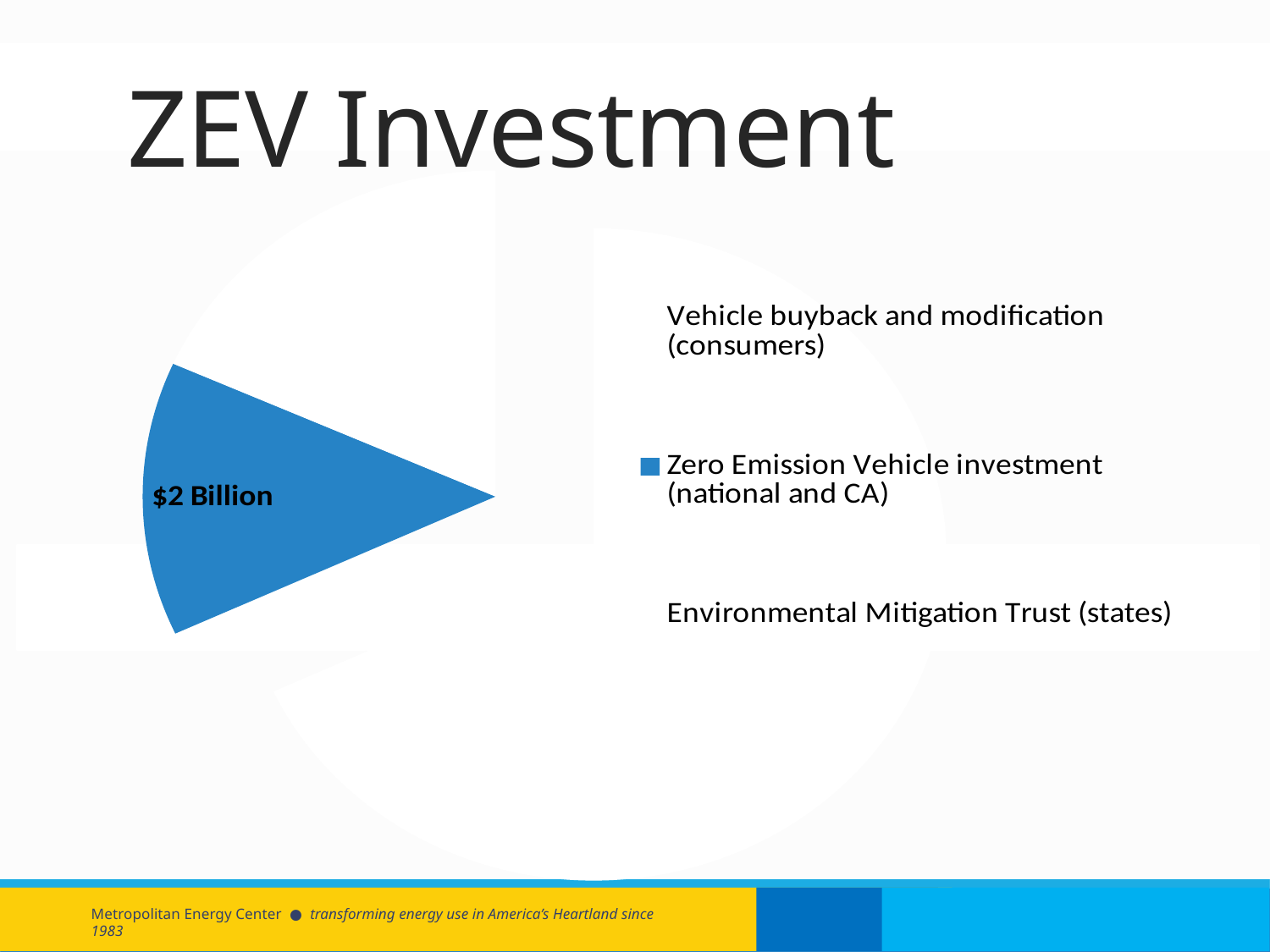
Which legend entry corresponds to the blue slice labelled $2 Billion? Zero Emission Vehicle investment (national and CA) What colour is the slice for Zero Emission Vehicle investment (national and CA)? Blue Which legend entry is listed first in the pie chart's legend? Vehicle buyback and modification (consumers) How many entries does the legend of the pie chart list? 3 What kind of chart is shown on the slide? Pie chart Which legend entry is listed last in the pie chart's legend? Environmental Mitigation Trust (states) What value is printed on the blue slice of the pie chart? $2 Billion